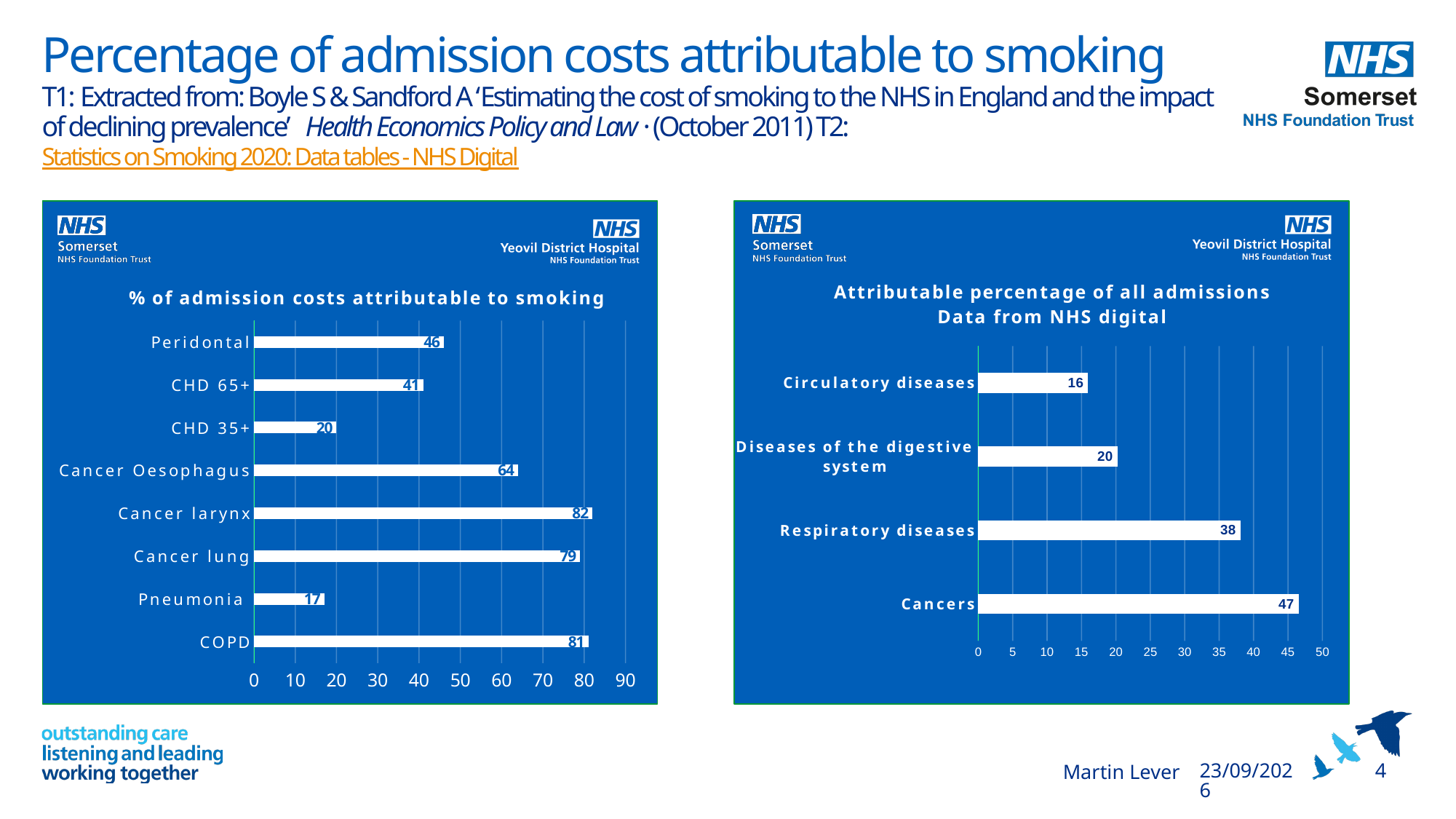
In the right chart 'Attributable percentage of all admissions', which category has the highest value? Cancers In the left chart '% of admission costs attributable to smoking', which category has the lowest value? Pneumonia What type of chart is the right chart 'Attributable percentage of all admissions'? Bar chart In the right chart 'Attributable percentage of all admissions', what is the value for Respiratory diseases? 38 In the left chart '% of admission costs attributable to smoking', what is the value for Cancer larynx? 82 In the right chart 'Attributable percentage of all admissions', which category has the lowest value? Circulatory diseases In the right chart 'Attributable percentage of all admissions', what is the difference between Cancers and Diseases of the digestive system? 27 In the left chart '% of admission costs attributable to smoking', how many categories are shown? 8 In the left chart '% of admission costs attributable to smoking', what is the difference between the values for CHD 65+ and CHD 35+? 21 In the left chart '% of admission costs attributable to smoking', what is the value for Pneumonia? 17 In the left chart '% of admission costs attributable to smoking', which category has the highest value? Cancer larynx In the left chart '% of admission costs attributable to smoking', which is larger, Cancer Oesophagus or Peridontal? Cancer Oesophagus